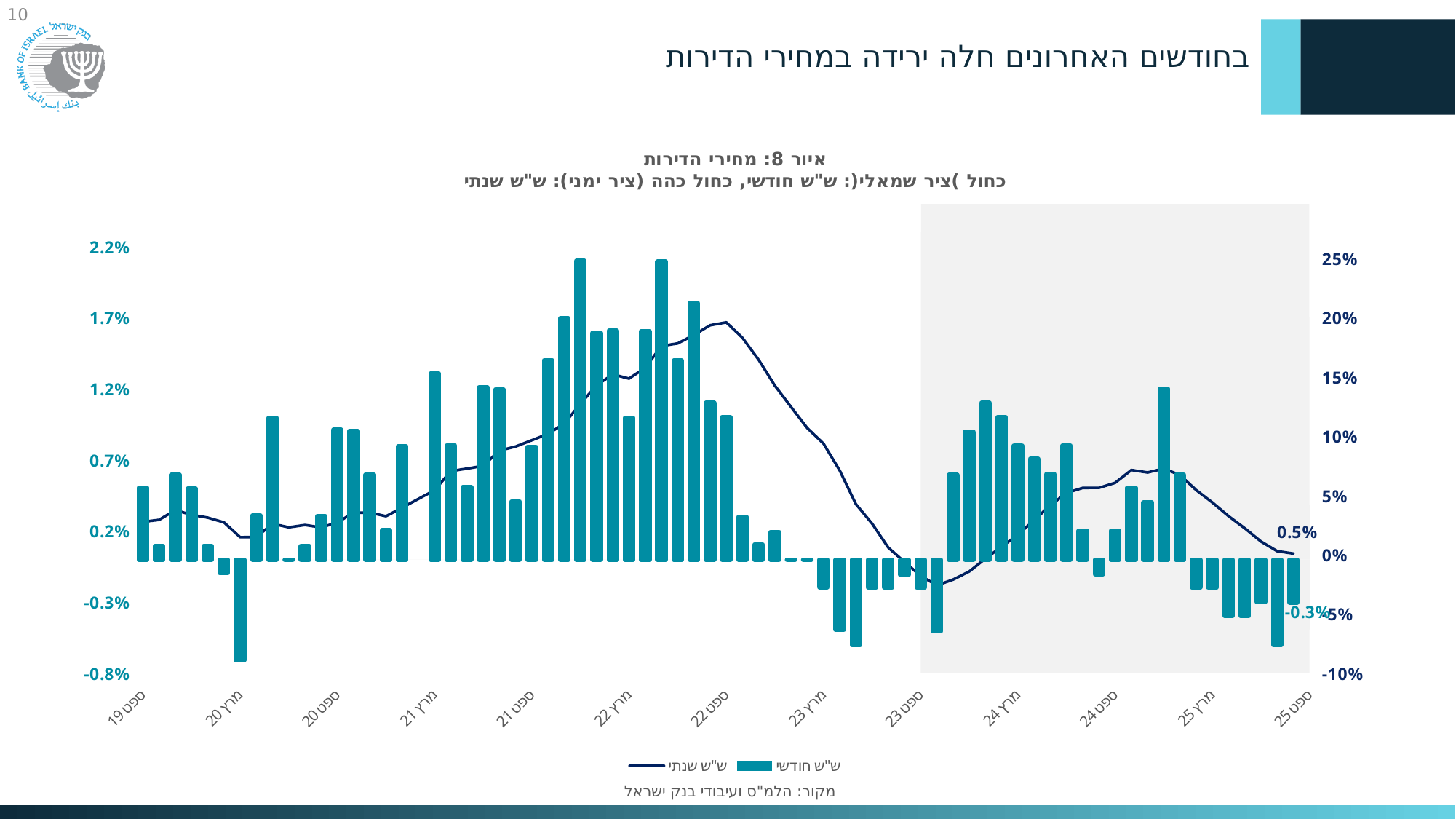
Is the peak of the annual change line (around מרץ 22) greater or less than 15% on the right axis? greater What is the highest tick value shown on the right-hand axis? 25% Does the annual change line rise or fall between ספט 23 and מרץ 25? rise Which is larger: the annual change line at מרץ 22 or at ספט 25? מרץ 22 What kind of chart is shown on the slide? A bar chart combined with a line What are the two legend entries of the chart? ש"ש חודשי and ש"ש שנתי Is the lowest monthly change bar (near מרץ 20) greater or less than -0.3% on the left axis? less How many labels are shown on the x axis? 13 Does the annual change line rise or fall between מרץ 22 and ספט 23? fall What is the labelled value of the annual change line (ש"ש שנתי) at the last point, ספט 25? 0.5% What is the labelled value of the last monthly change bar (ש"ש חודשי) at ספט 25? -0.3% How many series does the legend list? 2